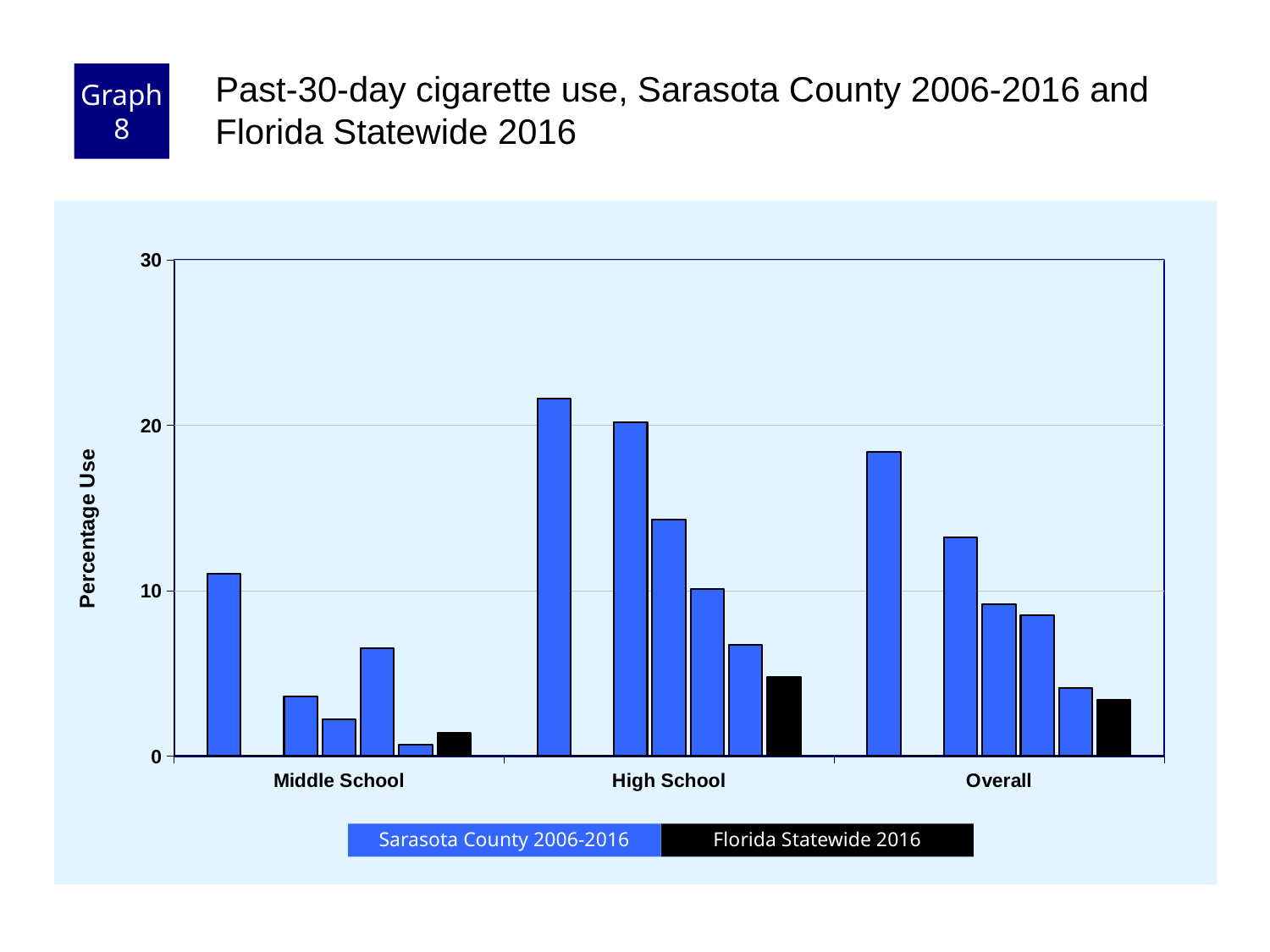
Is the value of the Florida Statewide 2016 bar in the High School group greater or less than 10? less Within the High School group, do the Sarasota County 2006-2016 bars rise or fall from left to right? fall Is the value of the tallest Sarasota County bar in the High School group greater or less than 20? greater What kind of chart is shown on the slide? bar chart Is the Florida Statewide 2016 bar larger for High School or for Middle School? High School Is the value of the tallest Sarasota County bar in the Overall group greater or less than 20? less How many categories are shown on the x axis? 3 Which category group contains the tallest bar on the chart? High School What is the label of the y axis? Percentage Use Which colour represents Florida Statewide 2016 in the legend? black How many series does the legend list? 2